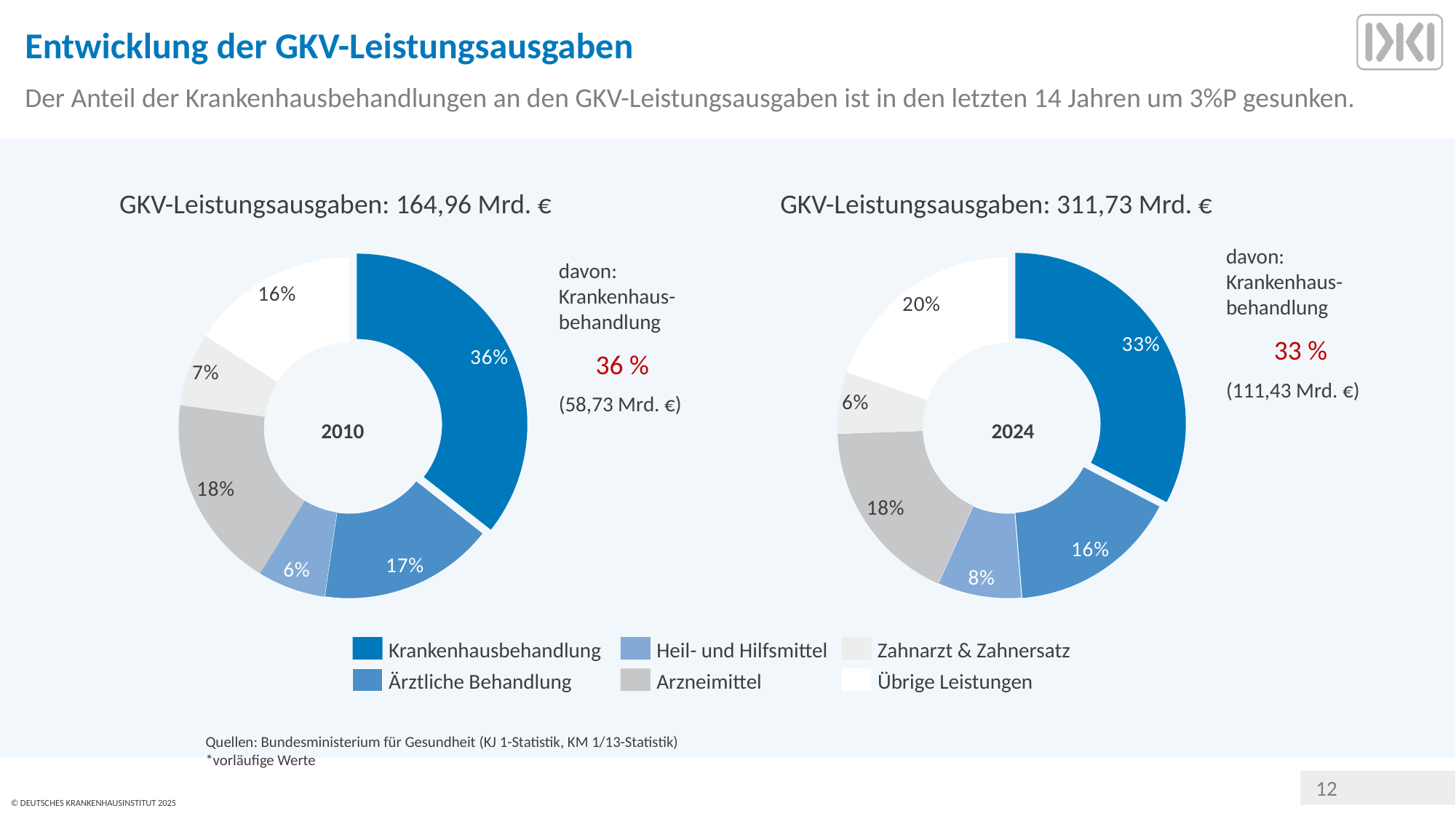
By how many percentage points did the share of Krankenhausbehandlung change from the 2010 chart to the 2024 chart? 3 percentage points lower What kind of charts are shown on the slide? Donut (pie) charts In the 2024 chart, which is larger: the share of Ärztliche Behandlung or the share of Heil- und Hilfsmittel? Ärztliche Behandlung How many categories does the legend list? 6 In the 2010 chart, which category has the largest share? Krankenhausbehandlung In the 2010 chart, what share of GKV-Leistungsausgaben is Krankenhausbehandlung? 36% In the 2024 chart, what share of GKV-Leistungsausgaben is Krankenhausbehandlung? 33% What is the total GKV-Leistungsausgaben given in the title of the 2024 chart? 311,73 Mrd. € In the 2010 chart, what share is Arzneimittel? 18% What amount in Mrd. € is given for Krankenhausbehandlung next to the 2010 chart? 58,73 Mrd. € In the 2024 chart, what share is Übrige Leistungen? 20% In the 2024 chart, which category has the smallest share? Zahnarzt & Zahnersatz